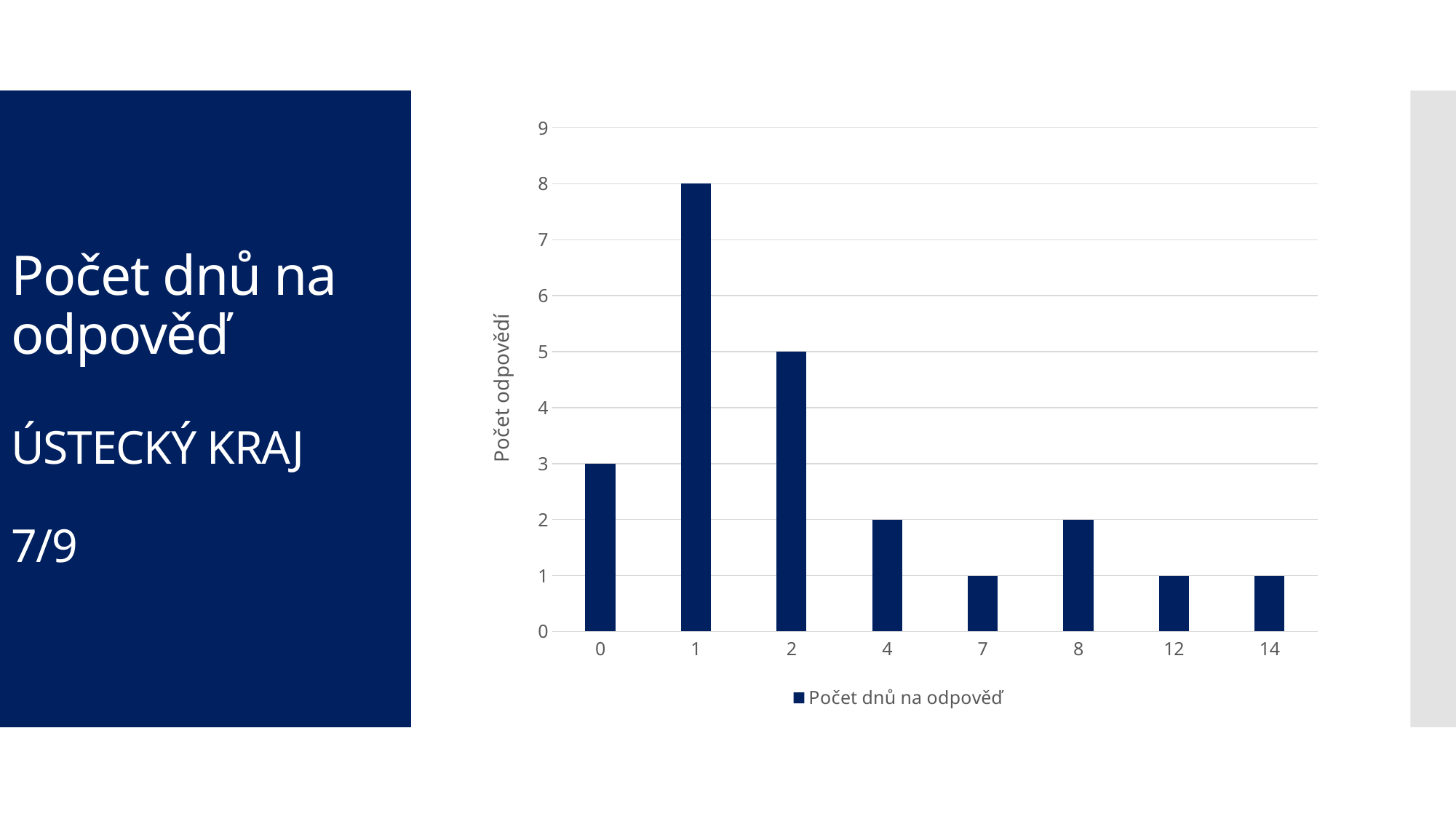
How many categories are shown on the x axis of the chart? 8 What kind of chart is shown on the slide? bar chart What is the label of the vertical axis? Počet odpovědí What is the legend entry shown below the chart? Počet dnů na odpověď Which category has the highest bar in the chart? 1 What is the value for category 1 in the chart? 8 What is the value for category 0 in the chart? 3 What is the difference between the values for category 1 and category 2? 3 What is the value for category 2 in the chart? 5 How many series does the legend list? 1 Which is larger, the value for category 0 or the value for category 4? 0 Is the value for category 1 greater or less than 6? greater